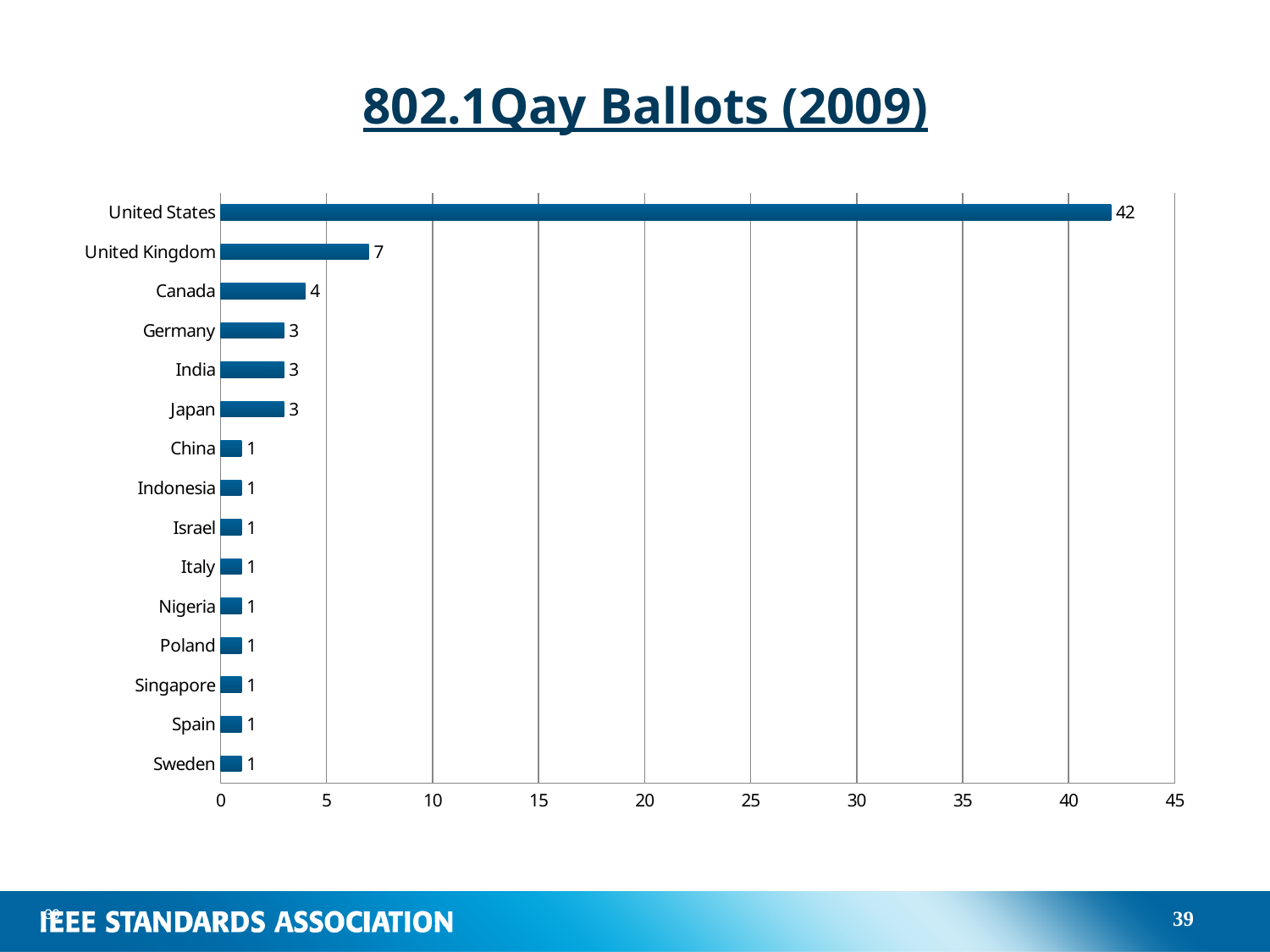
What is the value for Japan? 3 What is the difference between the values for United States and United Kingdom? 35 Which is larger, the value for Canada or the value for Germany? Canada How many countries are shown in the chart? 15 What is the value for United Kingdom? 7 What kind of chart is shown on the slide? bar chart What is the difference between the values for United Kingdom and Canada? 3 Which country has the highest value? United States Is the value for United States greater or less than 40? greater What is the value for United States? 42 What is the title of the chart? 802.1Qay Ballots (2009) What is the value for Canada? 4